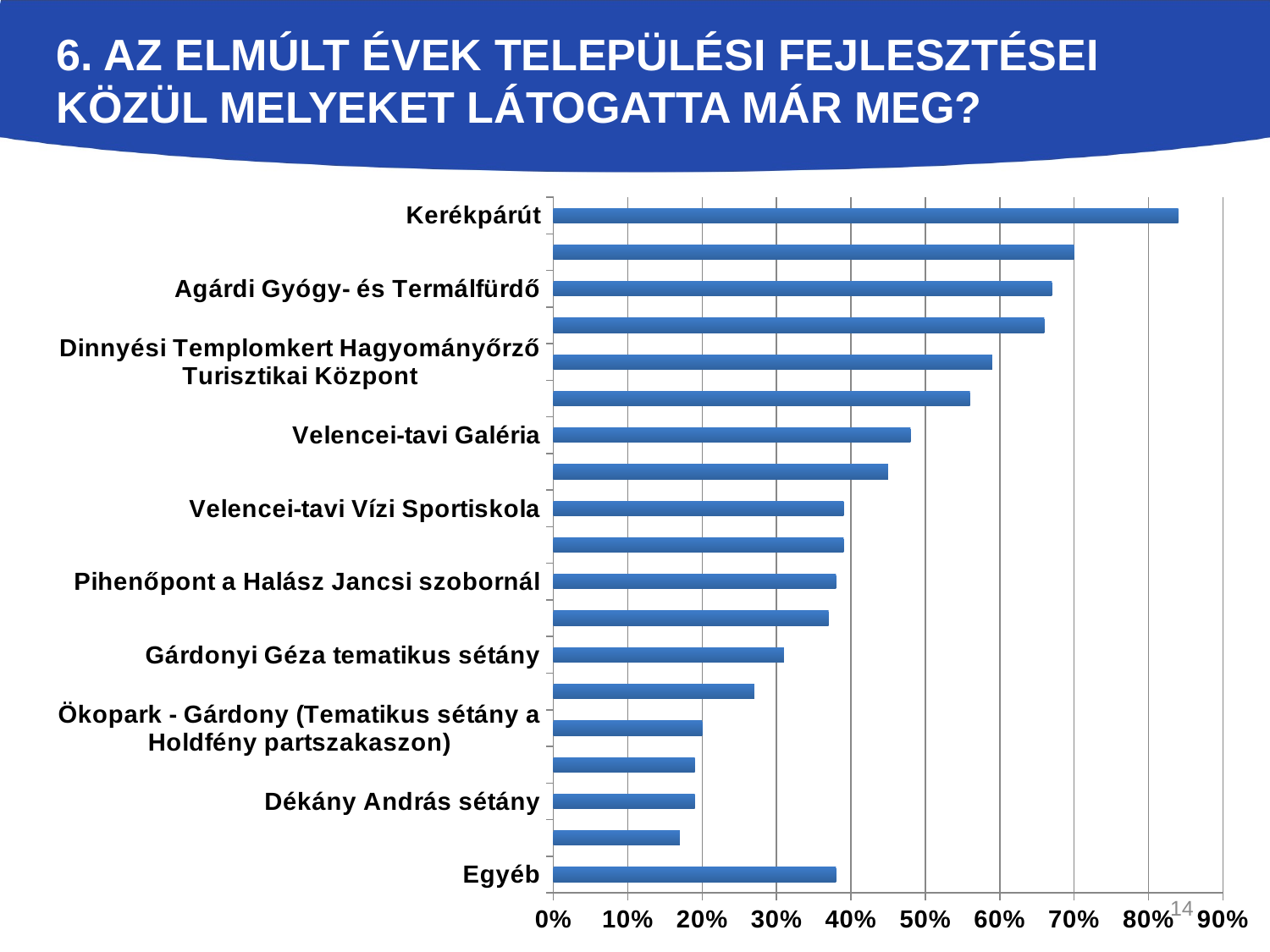
What kind of chart is shown on the slide? bar chart How many bars are plotted in the chart? 19 Which category has the highest value? Kerékpárút Is the value for Kerékpárút greater or less than 80%? greater What is the highest value shown on the horizontal axis? 90% Which is larger, the value for Velencei-tavi Galéria or the value for Gárdonyi Géza tematikus sétány? Velencei-tavi Galéria Is the value for Agárdi Gyógy- és Termálfürdő greater or less than 60%? greater Is the value for Egyéb greater or less than 30%? greater Which is larger, the value for Dinnyési Templomkert Hagyományőrző Turisztikai Központ or the value for Velencei-tavi Vízi Sportiskola? Dinnyési Templomkert Hagyományőrző Turisztikai Központ